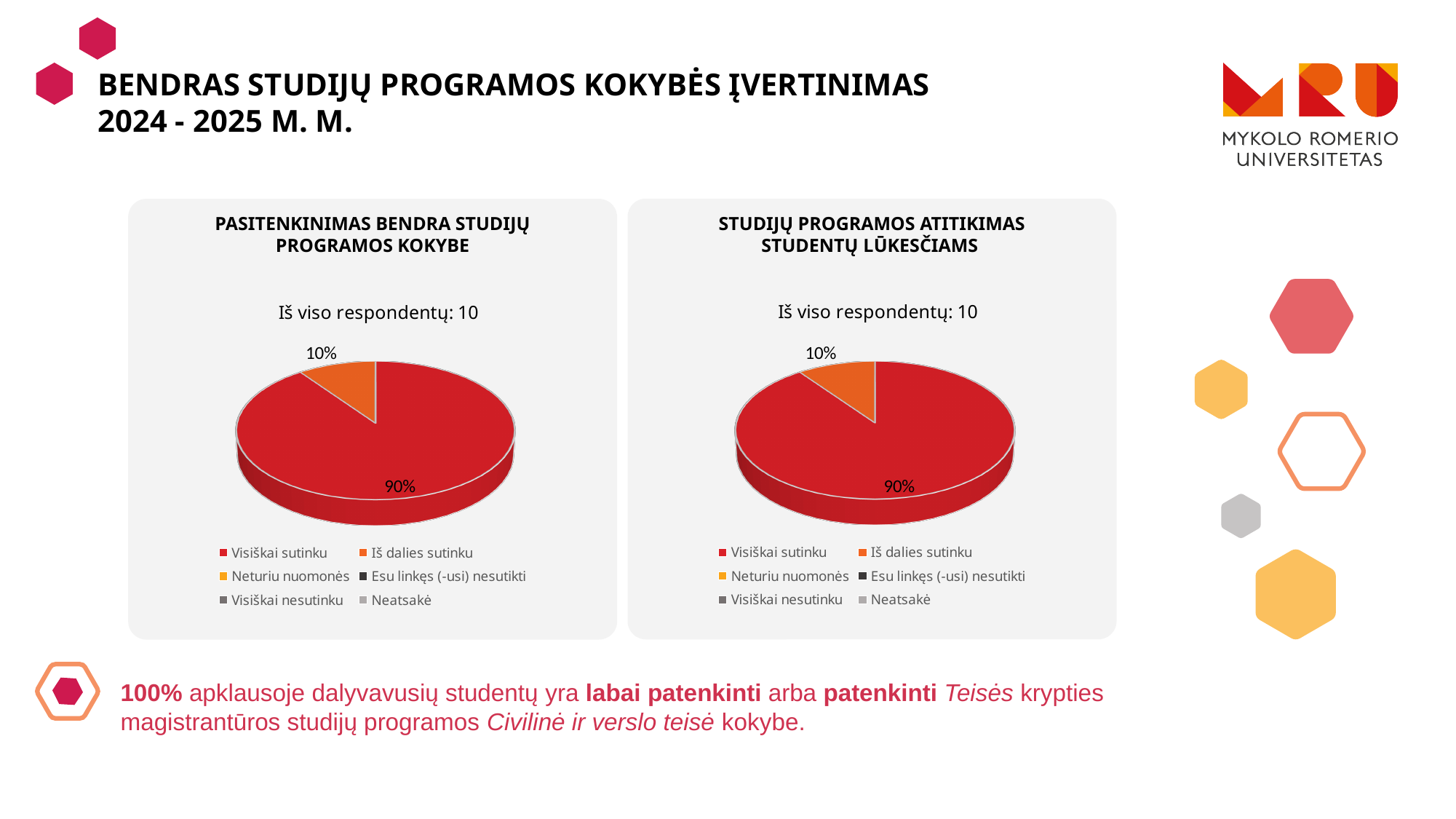
In the chart titled "STUDIJŲ PROGRAMOS ATITIKIMAS STUDENTŲ LŪKESČIAMS", what share of respondents answered "Iš dalies sutinku"? 10% In the right chart, which is larger: the "Visiškai sutinku" slice or the "Iš dalies sutinku" slice? Visiškai sutinku In the left chart, what colour is the "Iš dalies sutinku" slice? Orange In the left chart, what is the difference in percentage points between the "Visiškai sutinku" and "Iš dalies sutinku" slices? 80 percentage points In the chart titled "PASITENKINIMAS BENDRA STUDIJŲ PROGRAMOS KOKYBE", what share of respondents answered "Visiškai sutinku"? 90% In the chart titled "STUDIJŲ PROGRAMOS ATITIKIMAS STUDENTŲ LŪKESČIAMS", what share of respondents answered "Visiškai sutinku"? 90% In the right chart, which response category has the smallest non-zero slice? Iš dalies sutinku How many respondents in total are reported for the right chart? 10 In the left chart, which response category has the largest slice? Visiškai sutinku In the chart titled "PASITENKINIMAS BENDRA STUDIJŲ PROGRAMOS KOKYBE", what share of respondents answered "Iš dalies sutinku"? 10% How many entries does the legend of the left chart list? 6 What type of chart is used in the "PASITENKINIMAS BENDRA STUDIJŲ PROGRAMOS KOKYBE" panel? Pie chart